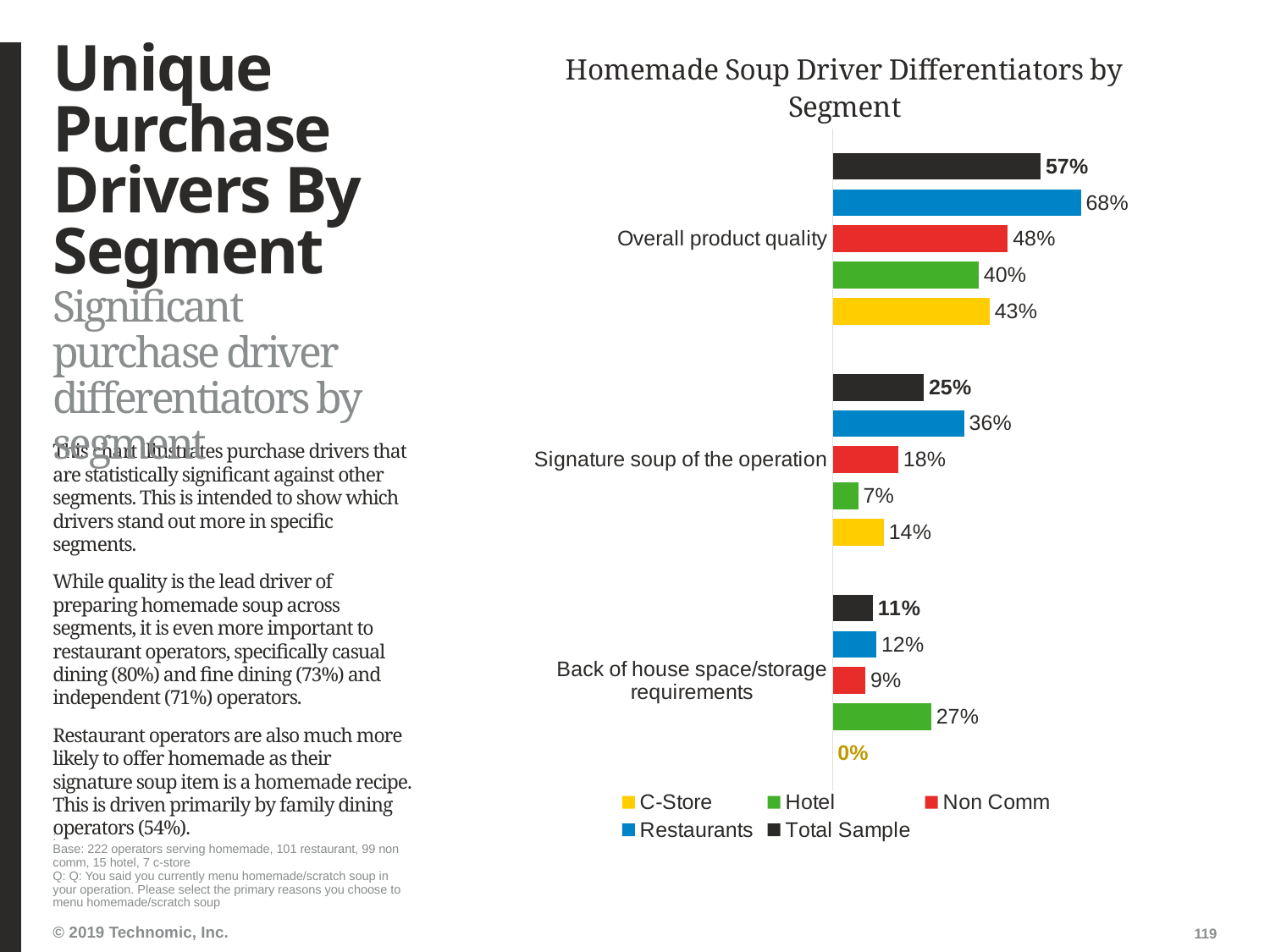
How many series does the legend list? 5 What is the title of the chart? Homemade Soup Driver Differentiators by Segment What is the C-Store value for Back of house space/storage requirements? 0% What is the difference between the Restaurants and Non Comm values for Overall product quality? 20% What is the Restaurants value for Overall product quality? 68% How many categories (purchase drivers) are shown on the chart? 3 What type of chart is shown on the slide? Bar chart Which segment has the highest value for Overall product quality? Restaurants What is the Total Sample value for Signature soup of the operation? 25% Which segment has the lowest value for Signature soup of the operation? Hotel Which is larger for Back of house space/storage requirements: the Hotel value or the Restaurants value? Hotel What is the Hotel value for Back of house space/storage requirements? 27%